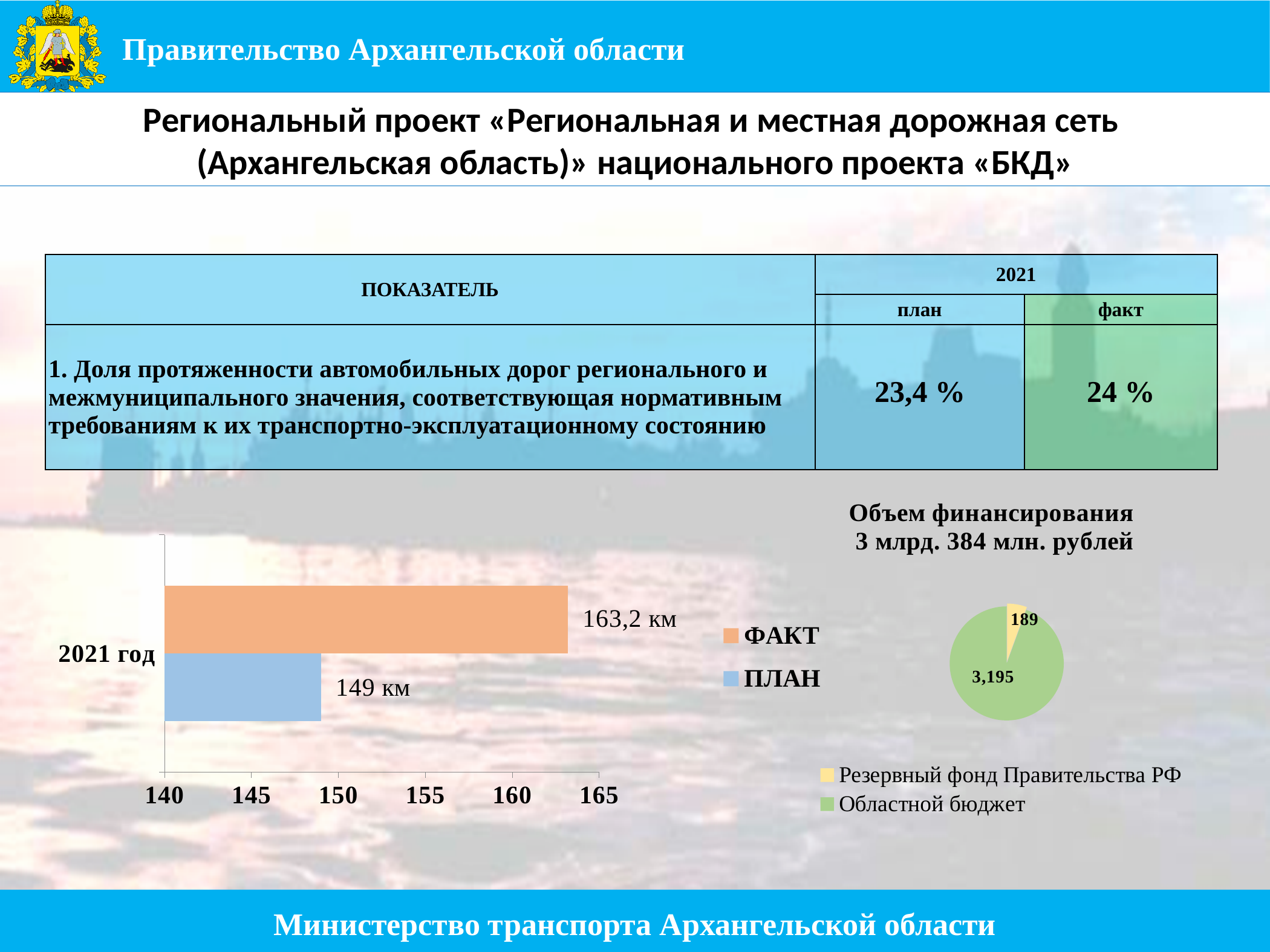
In the pie chart under Объем финансирования, what is the value for Резервный фонд Правительства РФ? 189 In the bar chart, what is the difference between the ФАКТ and ПЛАН values for 2021 год? 14,2 км In the pie chart under Объем финансирования, how many slices are there? 2 In the pie chart under Объем финансирования, what is the value for Областной бюджет? 3,195 In the bar chart, what is the value for ПЛАН in 2021 год? 149 км What kind of chart is the chart on the left showing ФАКТ and ПЛАН? bar chart What kind of chart is the chart on the right under Объем финансирования? pie chart In the pie chart under Объем финансирования, which slice is the largest? Областной бюджет In the bar chart, is the value for ПЛАН greater or less than 150? less In the bar chart, how many series does the legend list? 2 In the bar chart, which is larger for 2021 год, ФАКТ or ПЛАН? ФАКТ In the bar chart, what is the value for ФАКТ in 2021 год? 163,2 км